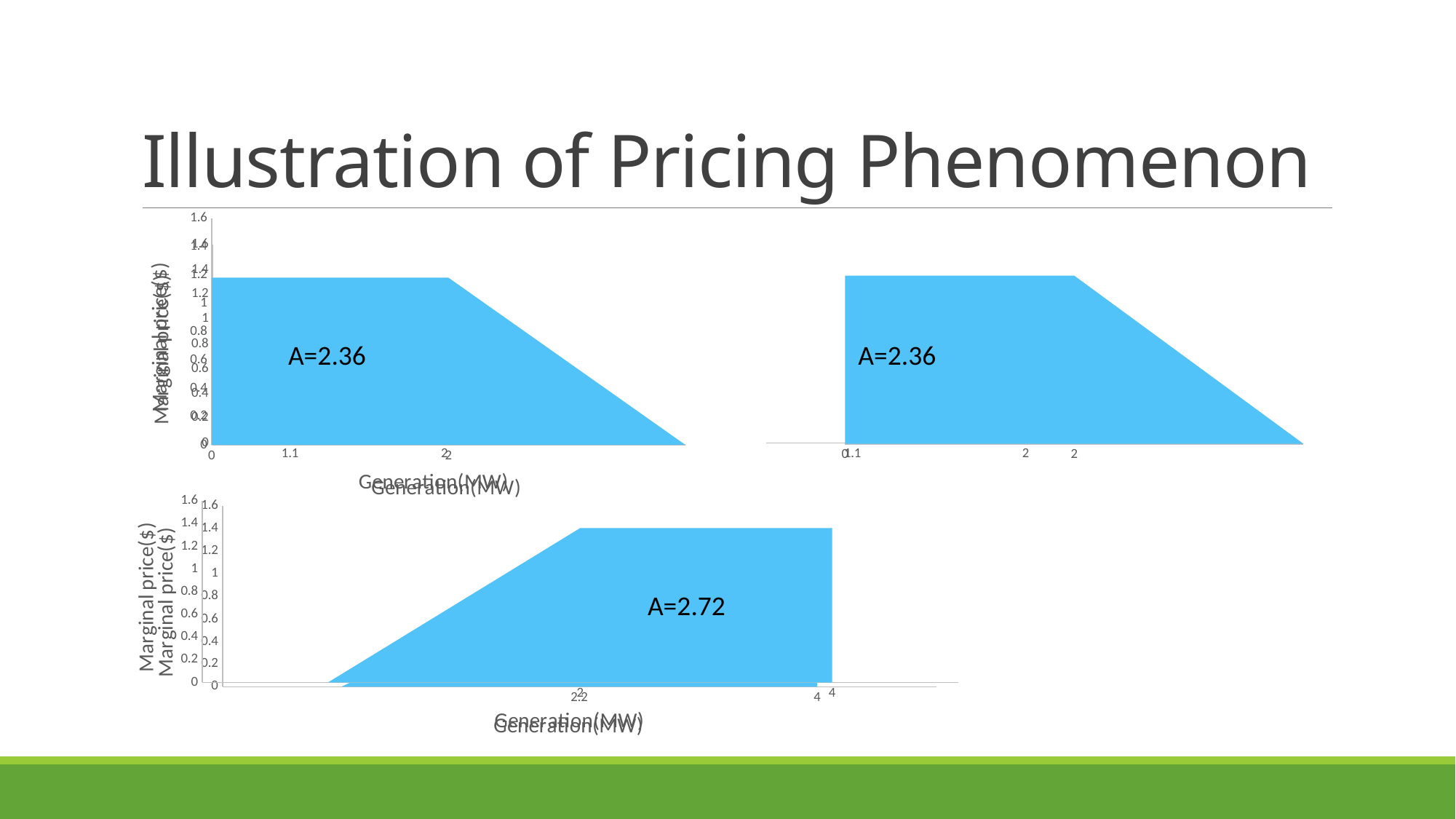
What kind of chart is the top-left chart on the slide? area chart What value of A is annotated on the bottom chart? A=2.72 What is the x-axis label on the top-left chart? Generation(MW) On the top-left chart, is the marginal price at a generation of 1.1 MW greater or less than 1? greater Which chart shows the larger annotated A value, the top-left chart or the bottom chart? the bottom chart What is the y-axis label on the bottom chart? Marginal price($) What is the difference between the A value on the bottom chart and the A value on the top-left chart? 0.36 On the bottom chart, is the marginal price at a generation of 4 MW greater or less than 1.2? greater On the top-left chart, does the marginal price rise or fall as generation increases beyond 2 MW? fall What value of A is annotated on the top-right chart? A=2.36 What value of A is annotated on the top-left chart? A=2.36 On the bottom chart, does the marginal price rise or fall as generation increases from 0 to 2 MW? rise